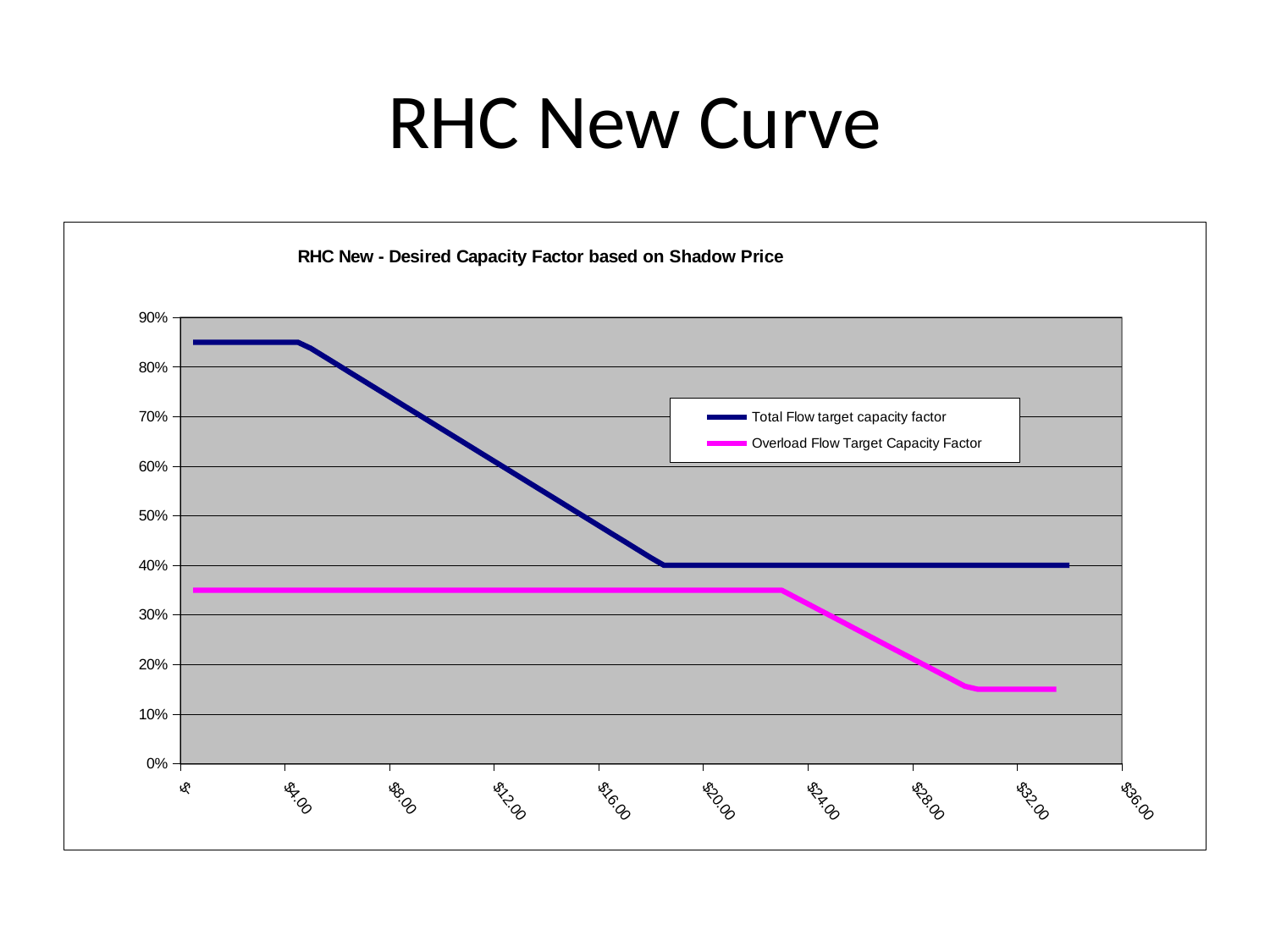
What kind of chart is shown on the slide? line chart Does the Total Flow target capacity factor rise or fall as the shadow price increases from $4.00 to $16.00? fall How many series does the legend list? 2 Which colour is used for the Overload Flow Target Capacity Factor line? magenta What is the title of the chart? RHC New - Desired Capacity Factor based on Shadow Price At a shadow price of $4.00, which series has the higher capacity factor? Total Flow target capacity factor Is the Total Flow target capacity factor at $16.00 greater or less than 40%? greater Is the Overload Flow Target Capacity Factor at $4.00 greater or less than 40%? less Is the Total Flow target capacity factor at $0 greater or less than 80%? greater What is the Total Flow target capacity factor at a shadow price of $24.00? 40% Does the Overload Flow Target Capacity Factor rise, fall, or stay flat between $0 and $20.00? stay flat